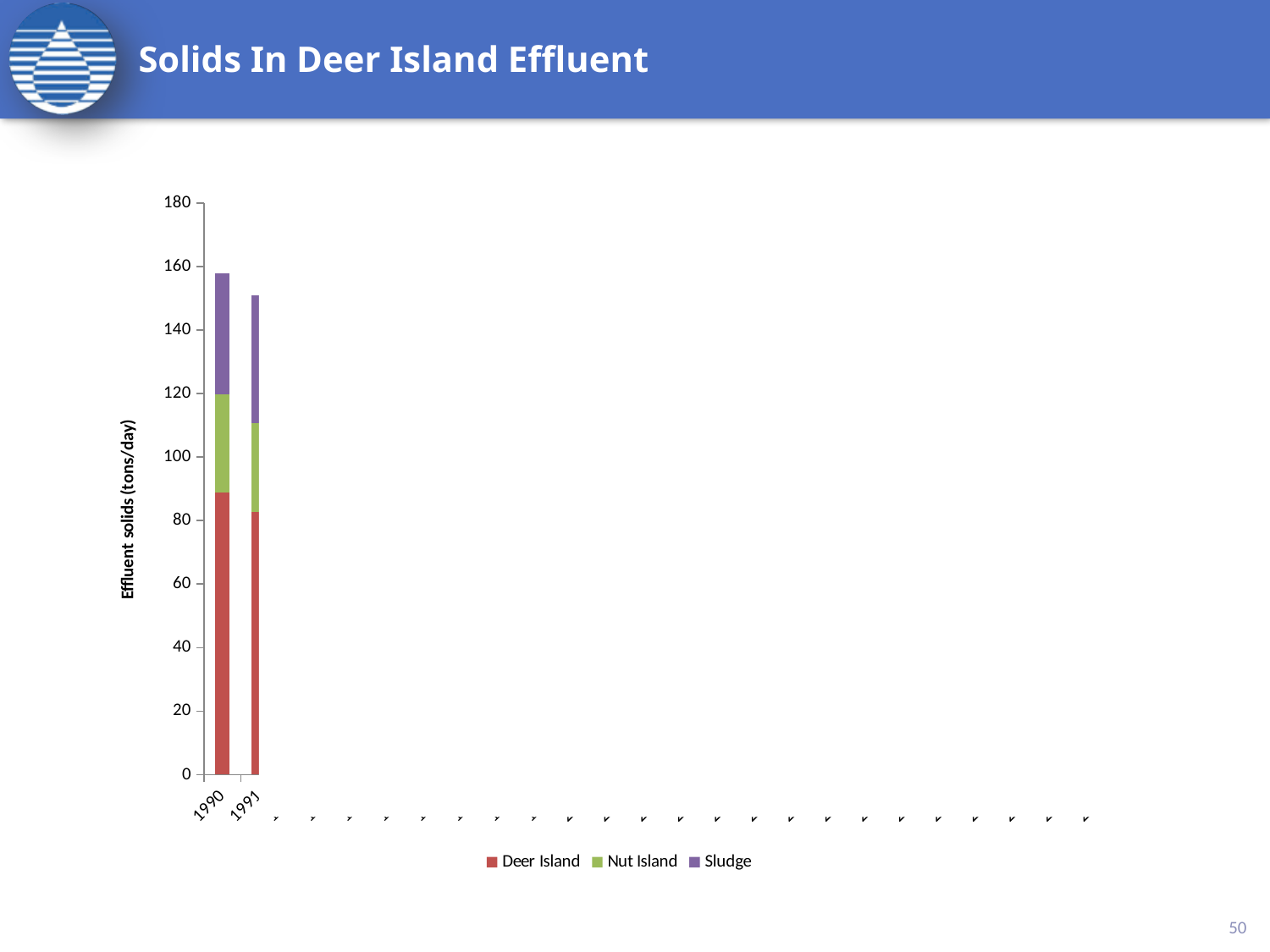
Is the total height of the 1990 bar greater or less than 140? greater Is the Deer Island value for 1990 greater or less than 80? greater How many bars are plotted on the chart? 2 Which year has the taller stacked bar, 1990 or 1991? 1990 Is the total height of the 1991 bar greater or less than 160? less What is the label on the y axis? Effluent solids (tons/day) What are the three series named in the legend? Deer Island, Nut Island, Sludge Which year has the larger Deer Island segment, 1990 or 1991? 1990 Does the total effluent solids rise or fall from 1990 to 1991? fall How many series does the legend list? 3 What kind of chart is shown on the slide? stacked bar chart